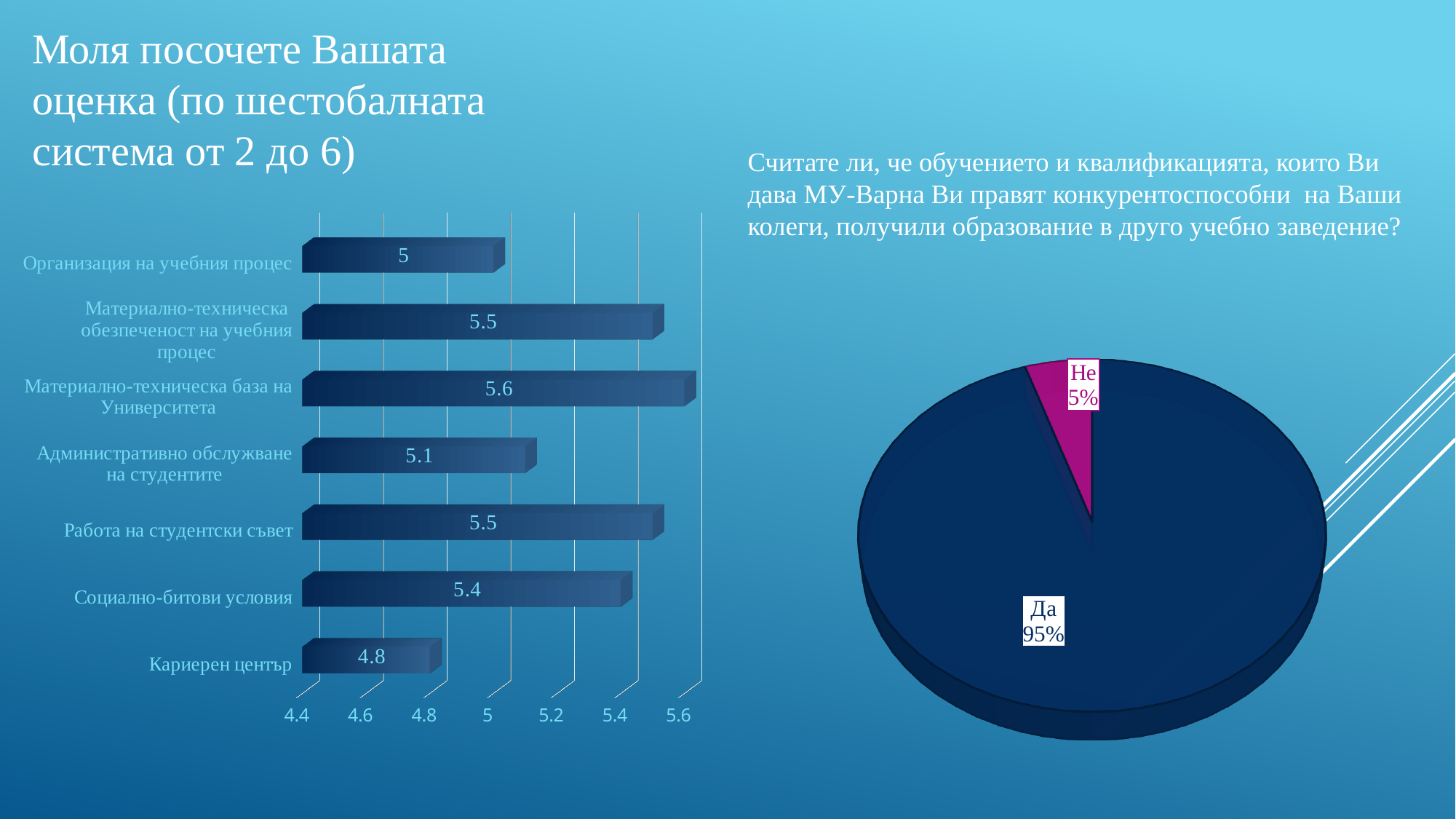
In the pie chart on the right, what share does the Да slice have? 95% In the bar chart on the left, what is the difference between the values for Материално-техническа база на Университета and Кариерен център? 0.8 In the bar chart on the left, what is the value for Кариерен център? 4.8 In the bar chart on the left, which is larger: the value for Социално-битови условия or the value for Организация на учебния процес? Социално-битови условия In the bar chart on the left, which category has the lowest value? Кариерен център What kind of chart is shown on the left of the slide? Bar chart How many categories does the bar chart on the left show? 7 What kind of chart is shown on the right of the slide? Pie chart In the bar chart on the left, what is the value for Социално-битови условия? 5.4 In the pie chart on the right, what share does the Не slice have? 5% In the bar chart on the left, which category has the highest value? Материално-техническа база на Университета In the bar chart on the left, what is the value for Административно обслужване на студентите? 5.1